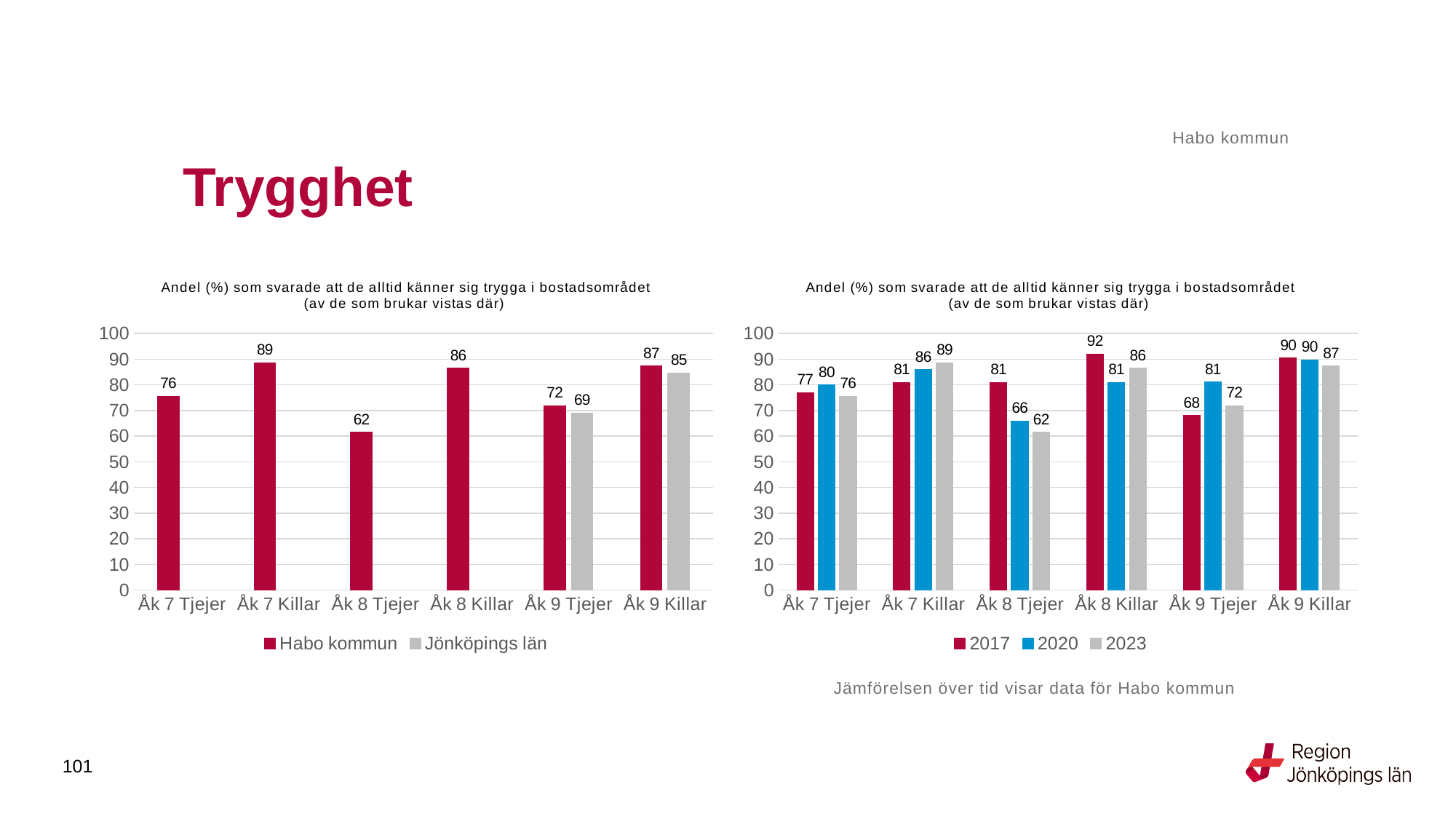
In the left chart, how many series does the legend list? 2 In the right chart, which series does the blue colour represent? 2020 In the right chart, which category has the highest 2017 value? Åk 8 Killar In the right chart, which category has the lowest 2023 value? Åk 8 Tjejer What kind of chart is the right chart? Bar chart In the left chart, what is the difference between Habo kommun and Jönköpings län for Åk 9 Tjejer? 3 In the right chart, what is the 2020 value for Åk 8 Tjejer? 66 In the left chart, which is larger for Åk 9 Killar: Habo kommun or Jönköpings län? Habo kommun In the right chart, what is the difference between the 2017 and 2023 values for Åk 8 Killar? 6 In the left chart, which category has the highest Habo kommun value? Åk 7 Killar In the right chart, how many categories are shown on the x axis? 6 In the left chart, what is the value for Habo kommun for Åk 8 Tjejer? 62